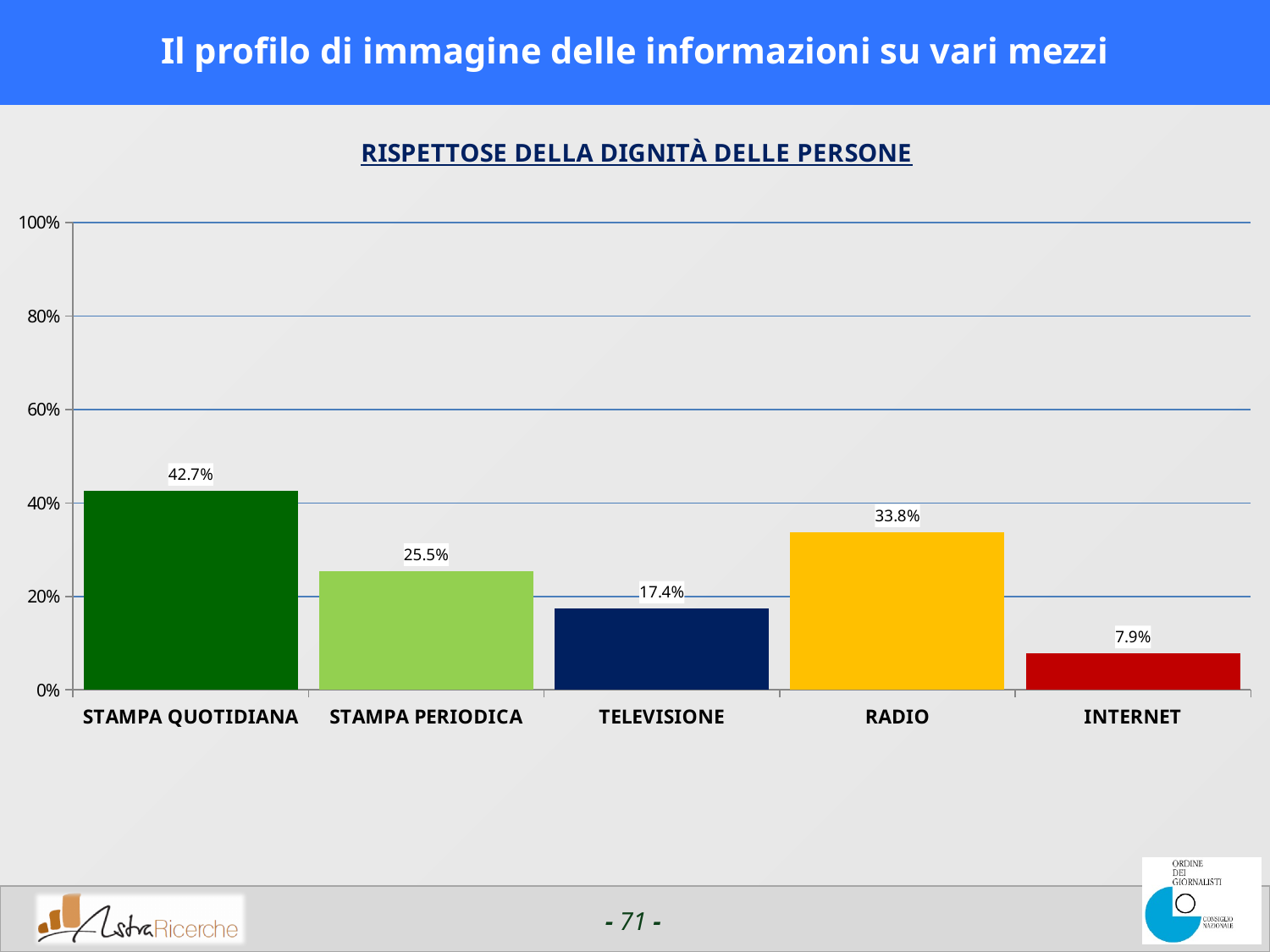
What is the difference between the values for STAMPA QUOTIDIANA and STAMPA PERIODICA? 17.2% Which is larger, the value for RADIO or the value for STAMPA PERIODICA? RADIO What kind of chart is shown on the slide? bar chart Is the value for TELEVISIONE greater or less than 20%? less Which category has the highest value? STAMPA QUOTIDIANA What is the title shown above the chart? RISPETTOSE DELLA DIGNITÀ DELLE PERSONE What is the value for INTERNET? 7.9% Which category has the lowest value? INTERNET What is the value for RADIO? 33.8% How many categories are shown on the x axis? 5 What is the value for TELEVISIONE? 17.4% What is the value for STAMPA QUOTIDIANA? 42.7%